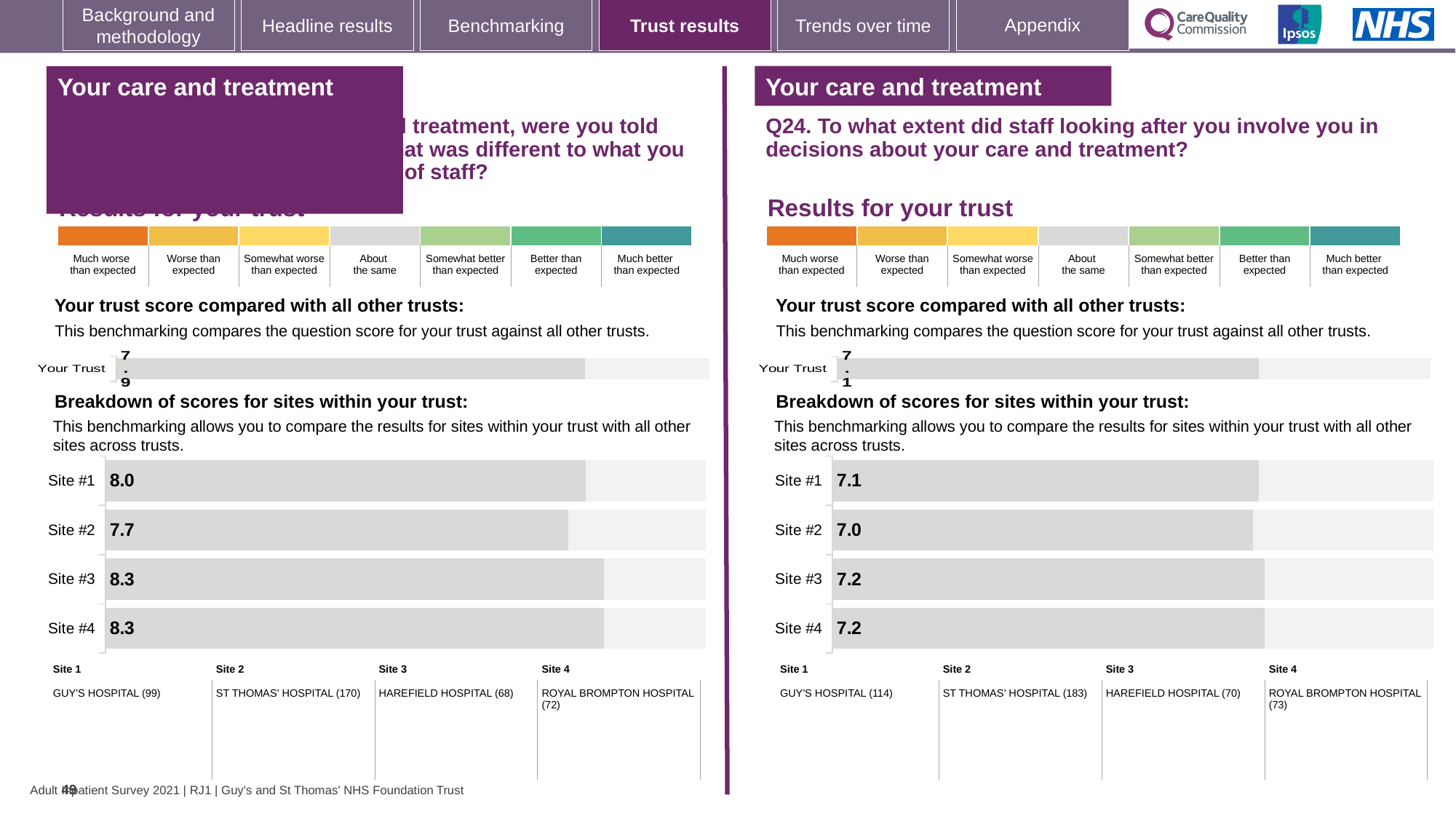
On the Q24 panel, what is the 'Your Trust' score shown in the trust benchmarking bar? 7.1 On the left-hand site breakdown chart, what is the score for Site #1? 8.0 Is the score for Site #1 higher on the left-hand site breakdown chart or on the Q24 site breakdown chart? Left-hand chart On the left-hand site breakdown chart, what is the difference between the scores for Site #3 and Site #2? 0.6 On the left-hand site breakdown chart, which site has the lowest score? Site #2 What type of chart is used for the site breakdown on the Q24 panel? Bar chart How many sites are shown in the Q24 site breakdown chart? 4 On the Q24 site breakdown chart (right-hand panel), what is the score for Site #4? 7.2 On the Q24 site breakdown chart (right-hand panel), what is the score for Site #2? 7.0 On the left-hand panel, what is the 'Your Trust' score shown in the trust benchmarking bar? 7.9 On the Q24 site breakdown chart (right-hand panel), which site has the lowest score? Site #2 On the left-hand site breakdown chart, what is the score for Site #2? 7.7